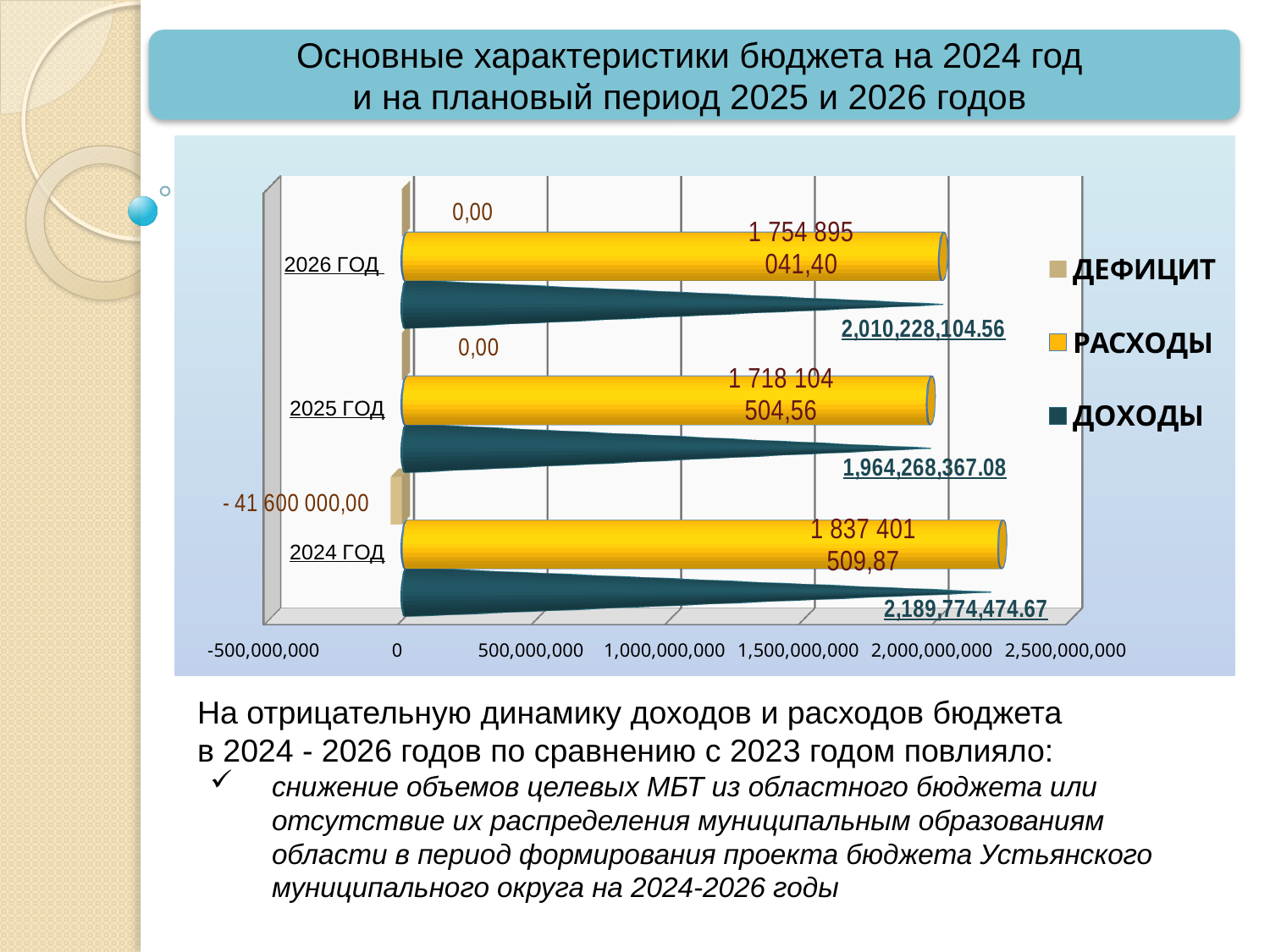
What is the difference between ДОХОДЫ for 2024 ГОД and ДОХОДЫ for 2025 ГОД? 225,506,107.59 What is the value of ДЕФИЦИТ for 2024 ГОД? -41 600 000,00 Which legend entry is shown in yellow? РАСХОДЫ What is the value of РАСХОДЫ for 2024 ГОД? 1 837 401 509,87 How many year categories are shown on the chart? 3 How many series does the legend list? 3 What is the value of ДОХОДЫ for 2026 ГОД? 2,010,228,104.56 Which year has the lowest РАСХОДЫ value? 2025 ГОД Which year has the highest ДОХОДЫ value? 2024 ГОД What is the value of ДЕФИЦИТ for 2025 ГОД? 0,00 What type of chart is shown on the slide? bar chart